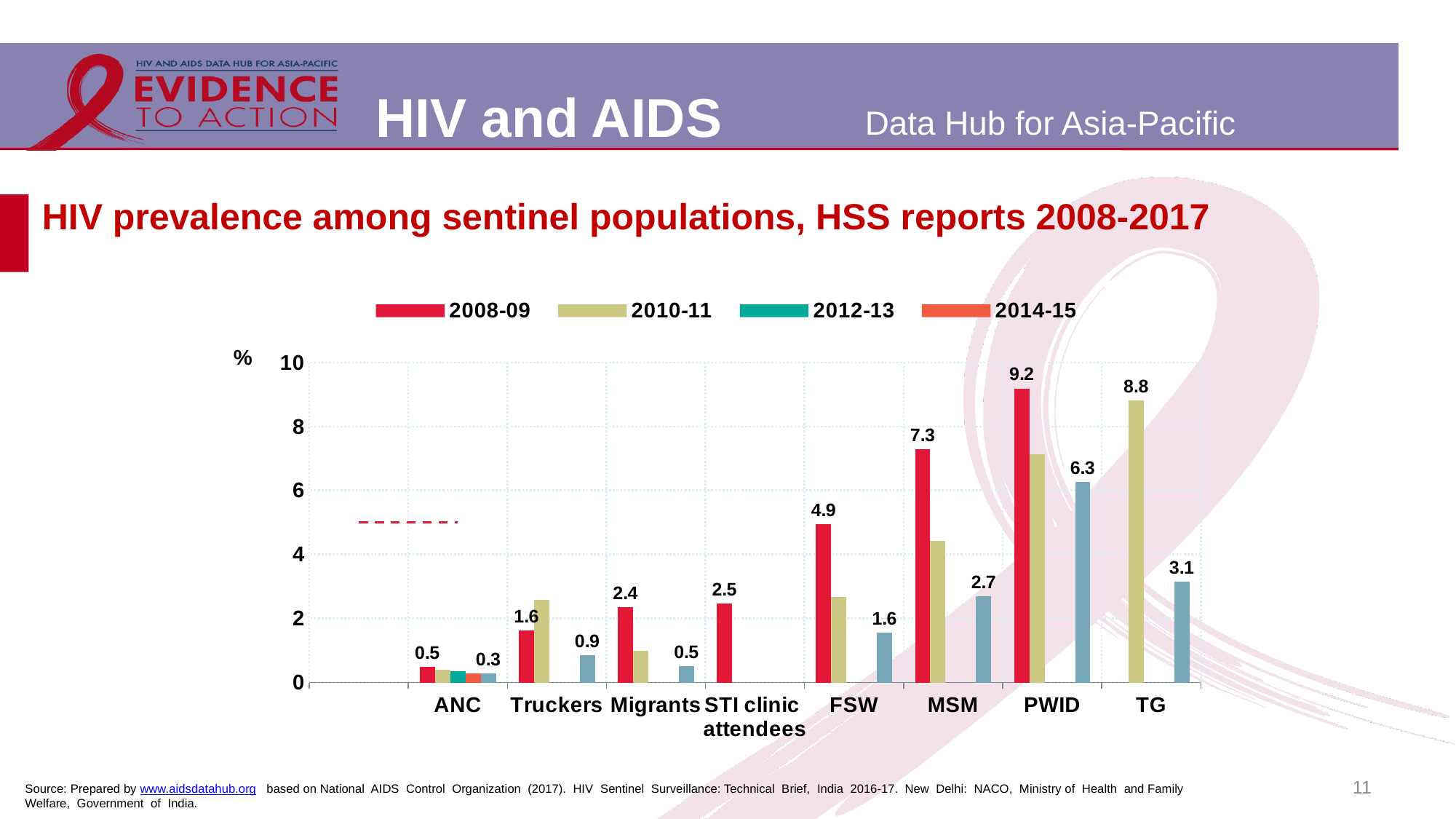
What is the 2008-09 value for FSW? 4.9 Which population has the highest 2008-09 value? PWID How many series does the legend list? 4 What is the 2008-09 value for MSM? 7.3 What is the 2010-11 value for TG? 8.8 What kind of chart is shown on the slide? bar chart What is the 2008-09 value for Truckers? 1.6 What is the difference between the 2008-09 values for PWID and MSM? 1.9 Is the 2010-11 value for PWID greater or less than 6? greater How many population categories are shown on the x axis? 8 Which is larger, the 2008-09 value for FSW or for MSM? MSM What is the 2008-09 HIV prevalence value for PWID? 9.2